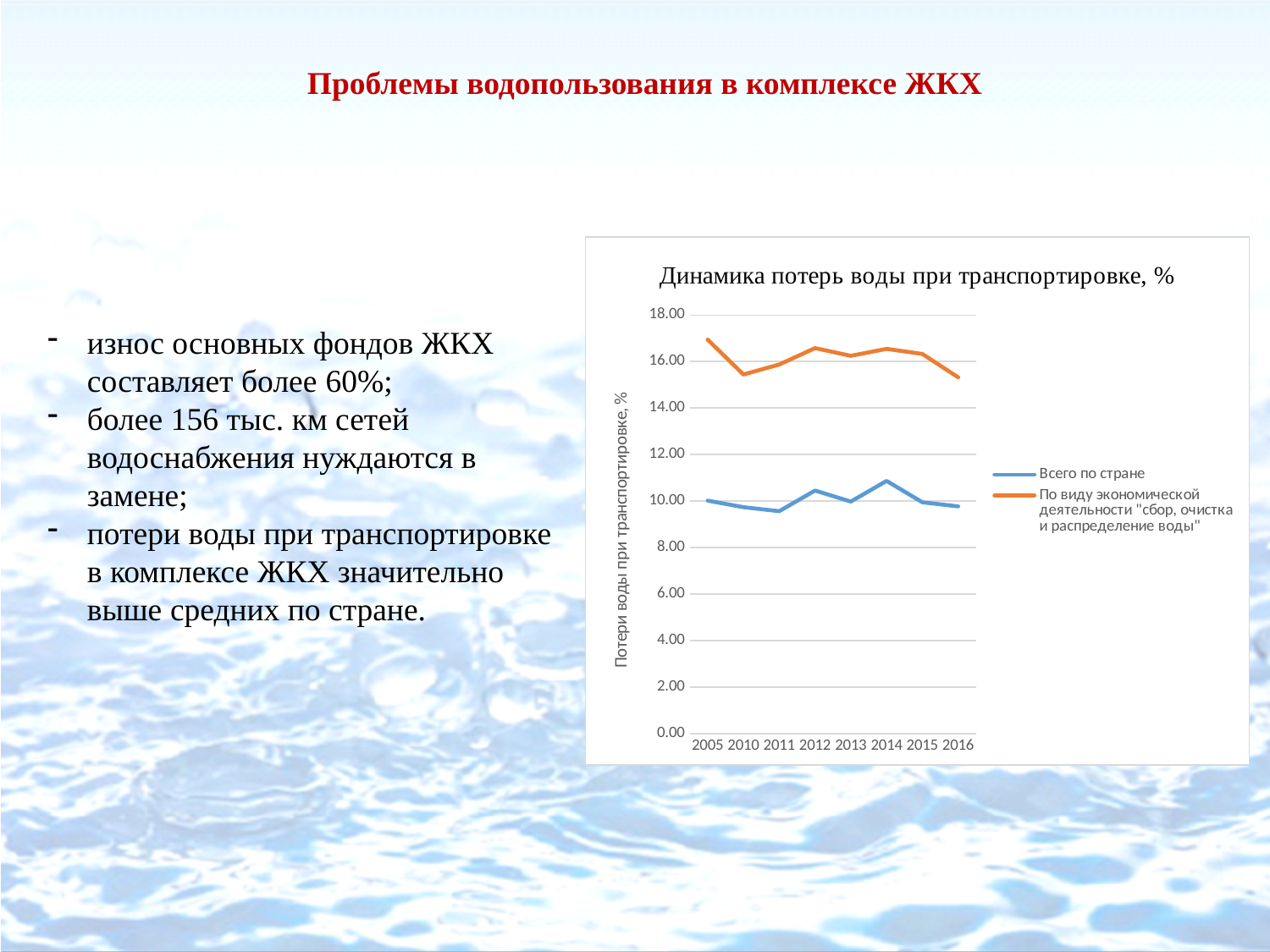
Does the series "По виду экономической деятельности "сбор, очистка и распределение воды"" rise or fall from 2005 to 2010? fall Is the value for "По виду экономической деятельности "сбор, очистка и распределение воды"" in 2010 greater or less than 16.00? less Is the value for "Всего по стране" in 2011 greater or less than 10.00? less What is the label of the vertical axis of the chart? Потери воды при транспортировке, % How many years are plotted along the x axis of the chart? 8 What kind of chart is shown on the slide? line chart In which year does the series "Всего по стране" reach its highest value? 2014 In which year does the series "По виду экономической деятельности "сбор, очистка и распределение воды"" reach its highest value? 2005 Which series has the larger value in 2016, "Всего по стране" or "По виду экономической деятельности "сбор, очистка и распределение воды""? По виду экономической деятельности "сбор, очистка и распределение воды" What is the title of the chart? Динамика потерь воды при транспортировке, % How many series does the chart legend list? 2 Is the value for "Всего по стране" in 2014 greater or less than 10.00? greater